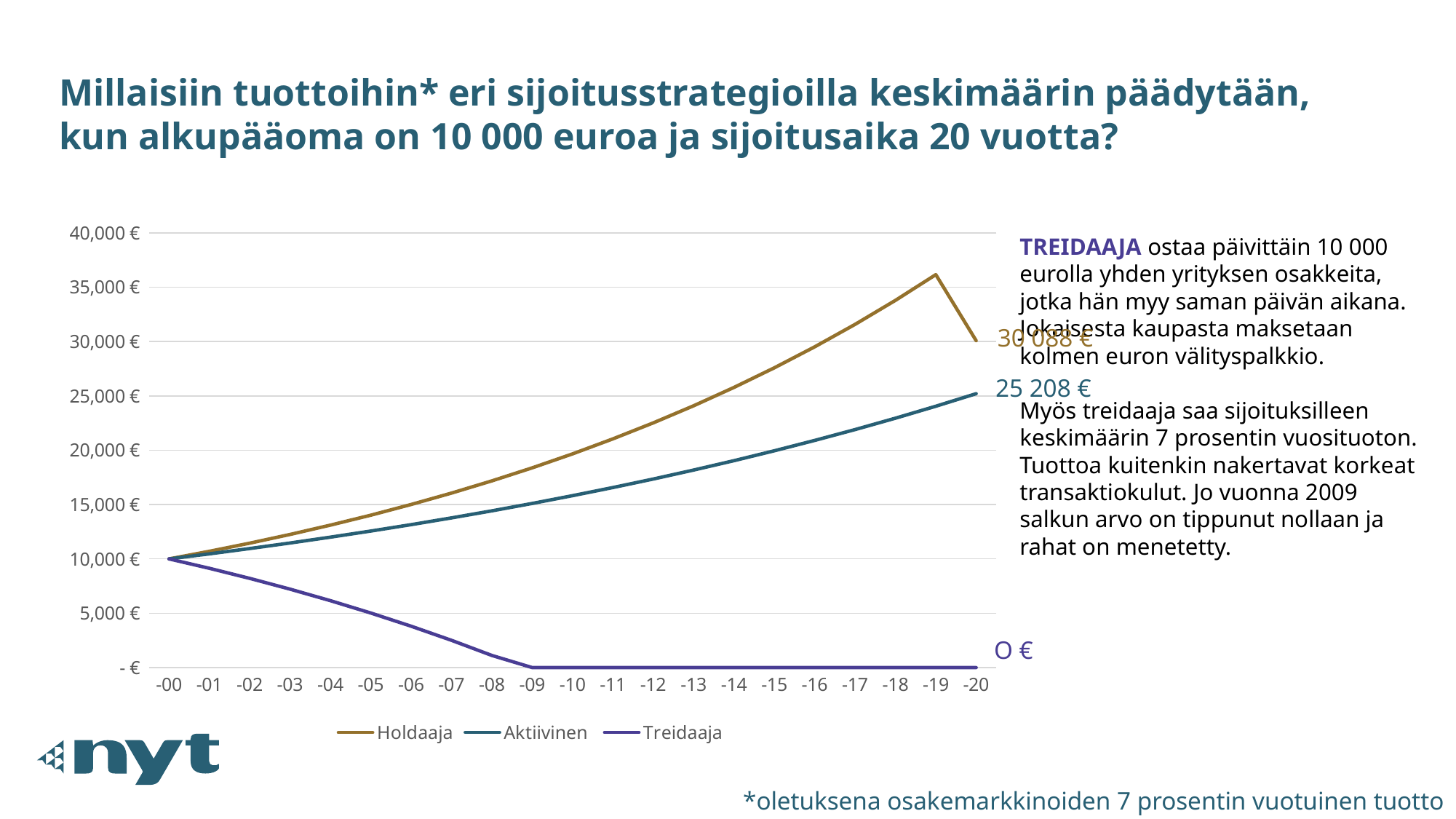
Is the value of the Holdaaja series at -15 greater or less than 25,000 €? greater Does the Treidaaja series rise or fall from -00 to -09? fall What is the value of the Aktiivinen series at -20? 25 208 € What is the difference between the Holdaaja and Aktiivinen values at -20? 4 880 € What is the value of the Holdaaja series at -20? 30 088 € What kind of chart is shown on the slide? line chart How many points are on the x axis? 21 What value do all three series start at in -00? 10,000 € Which series has the highest value at -20? Holdaaja How many series does the legend list? 3 Which series has the lowest value at -20? Treidaaja What is the value of the Treidaaja series at -20? 0 €